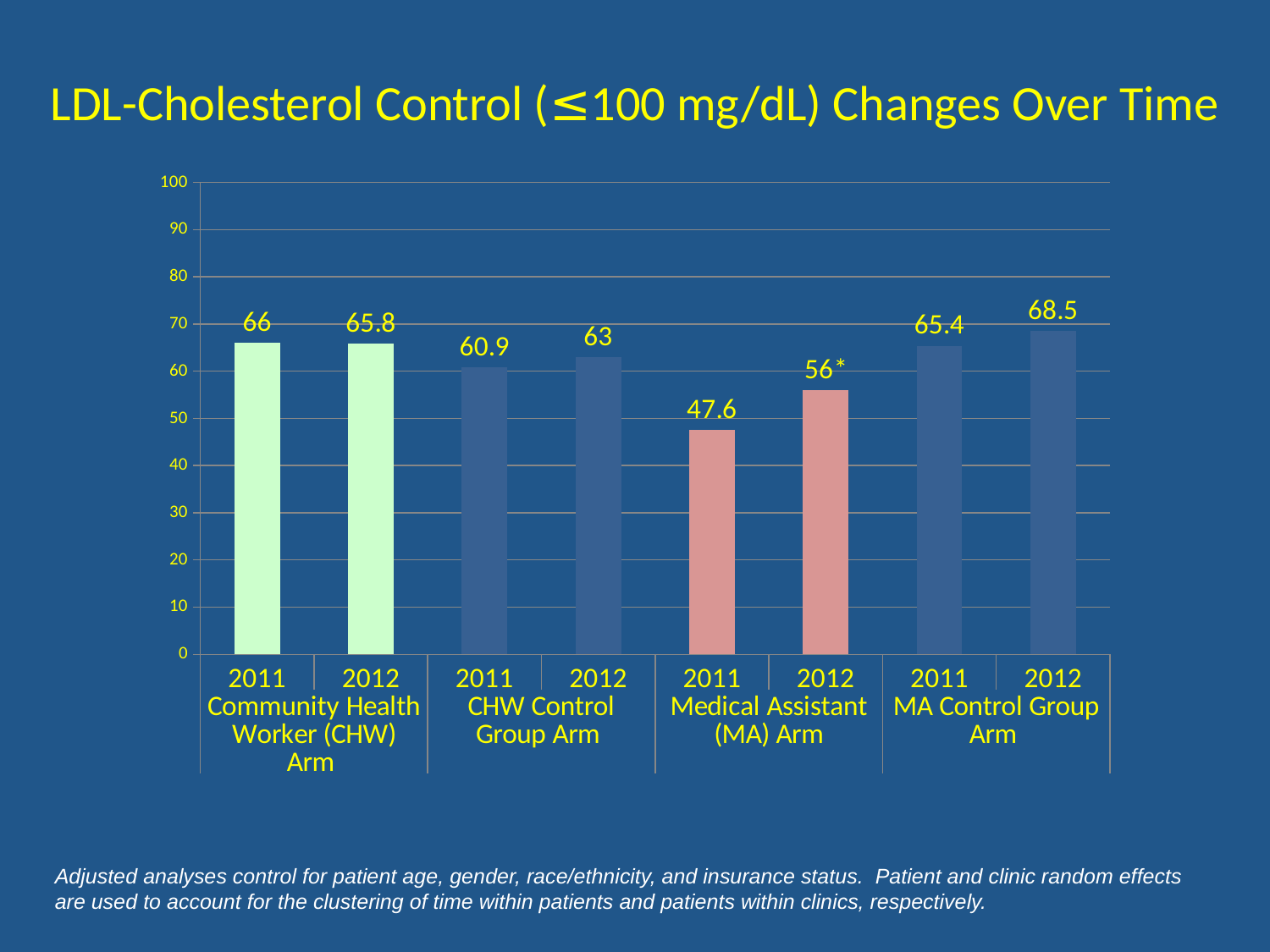
Which bar has the highest value? 2012 MA Control Group Arm Which is larger: the 2011 value in the Community Health Worker (CHW) Arm or the 2011 value in the MA Control Group Arm? 2011 Community Health Worker (CHW) Arm What is the title of the chart on the slide? LDL-Cholesterol Control (≤100 mg/dL) Changes Over Time What is the value for 2012 in the MA Control Group Arm? 68.5 What is the value for 2012 in the Medical Assistant (MA) Arm? 56 What is the value for 2011 in the CHW Control Group Arm? 60.9 What kind of chart is shown on the slide? Bar chart What is the value for 2011 in the Community Health Worker (CHW) Arm? 66 Which bar has the lowest value? 2011 Medical Assistant (MA) Arm How many bars are plotted on the chart? 8 What is the difference between the 2012 and 2011 values in the CHW Control Group Arm? 2.1 What is the difference between the 2012 and 2011 values in the Medical Assistant (MA) Arm? 8.4